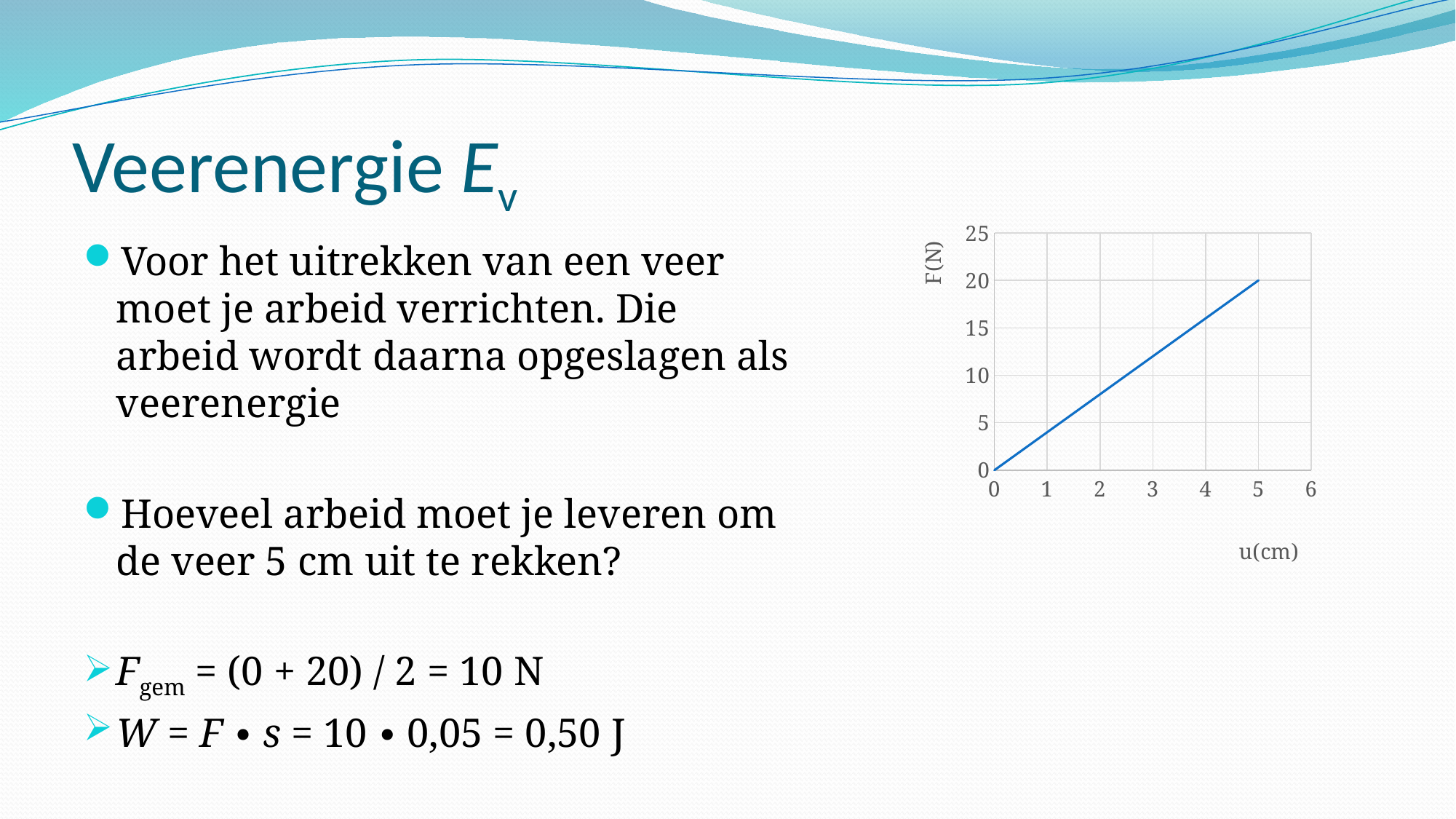
What kind of chart is shown on the slide? line chart Is the value of F at u = 3 cm greater or less than 15? less What is the label of the horizontal axis of the chart? u(cm) What is the value of F (N) when u is 0 cm? 0 Is the value of F at u = 4 cm greater or less than 15? greater Does F rise or fall as u increases along the x axis? rise Is the value of F at u = 1 cm greater or less than 5? less What is the value of F (N) when u is 5 cm? 20 What is the label of the vertical axis of the chart? F (N) What is the difference between F at u = 5 cm and F at u = 0 cm? 20